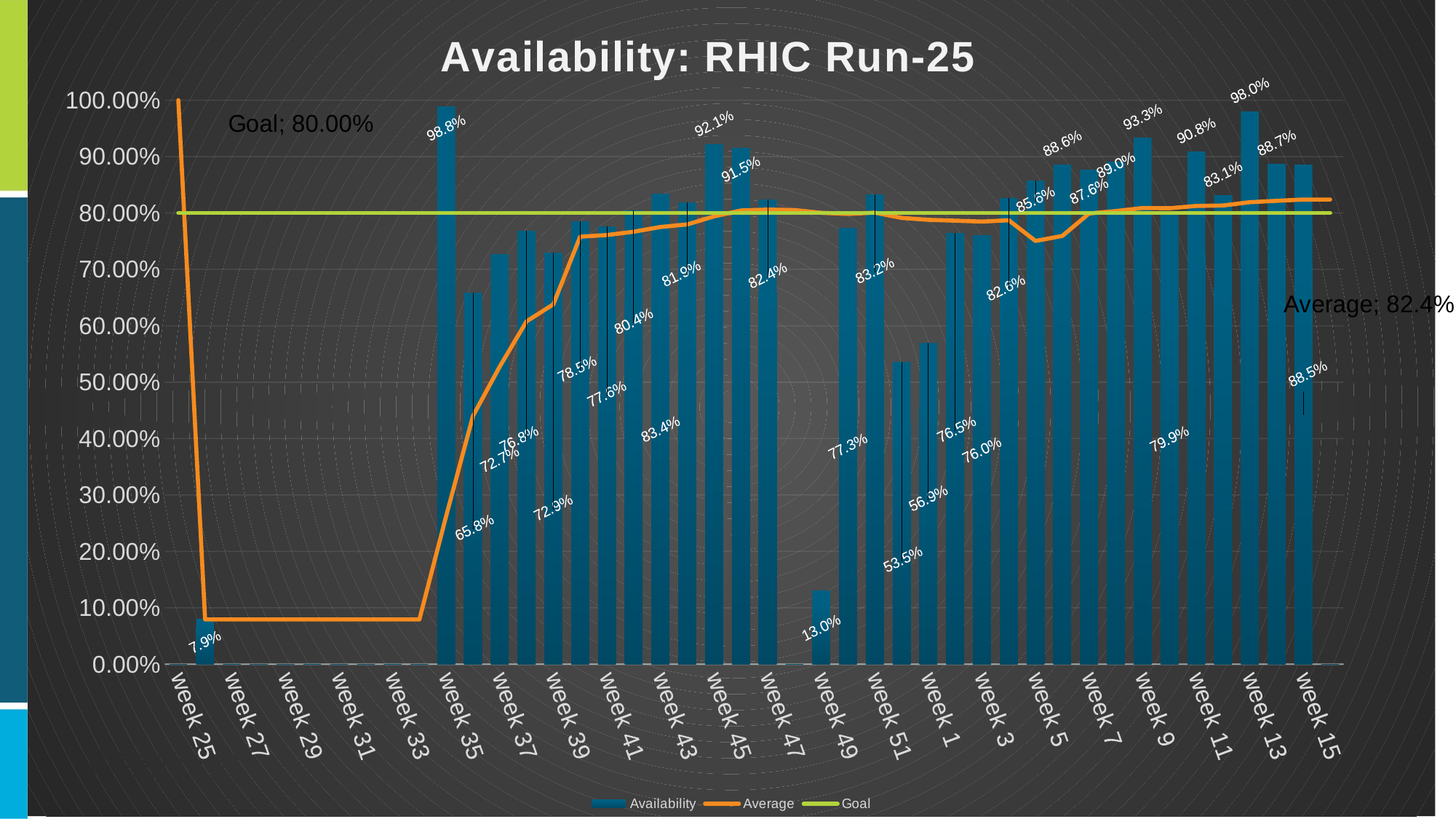
What is the availability for week 49? 13.0% Which has the higher availability, week 1 or week 3? week 3 Which week has the highest availability bar? week 35 Is the availability for week 1 greater or less than 60%? less What is the availability for week 35? 98.8% What value is shown for the Goal line? 80.00% How many series does the legend list? 3 What is the title of the chart? Availability: RHIC Run-25 What is the availability for week 13? 98.0% What is the Average value annotated on the chart? 82.4% What kind of chart is used to show the Availability series? bar chart